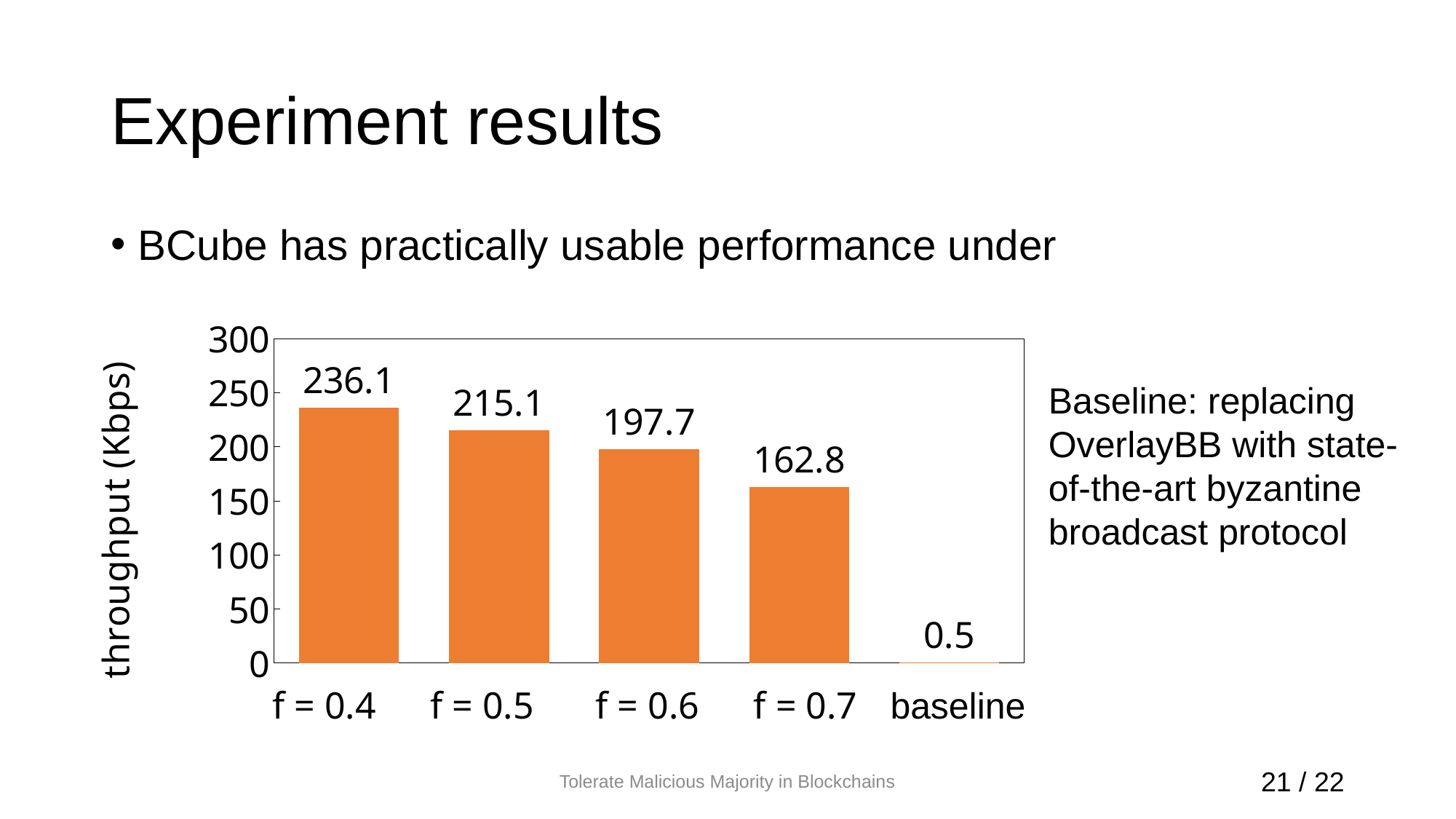
Which category has the lowest throughput? baseline What is the difference in throughput between f = 0.4 and f = 0.5? 21.0 What is the difference in throughput between f = 0.6 and f = 0.7? 34.9 What is the throughput for the baseline? 0.5 Which category has the highest throughput? f = 0.4 What kind of chart is shown on the slide? bar chart How many categories are shown on the x axis? 5 Which has a higher throughput, f = 0.5 or f = 0.6? f = 0.5 What is the label of the y axis? throughput (Kbps) What is the throughput for f = 0.7? 162.8 Is the throughput for f = 0.6 greater or less than 200? less What is the throughput for f = 0.4? 236.1